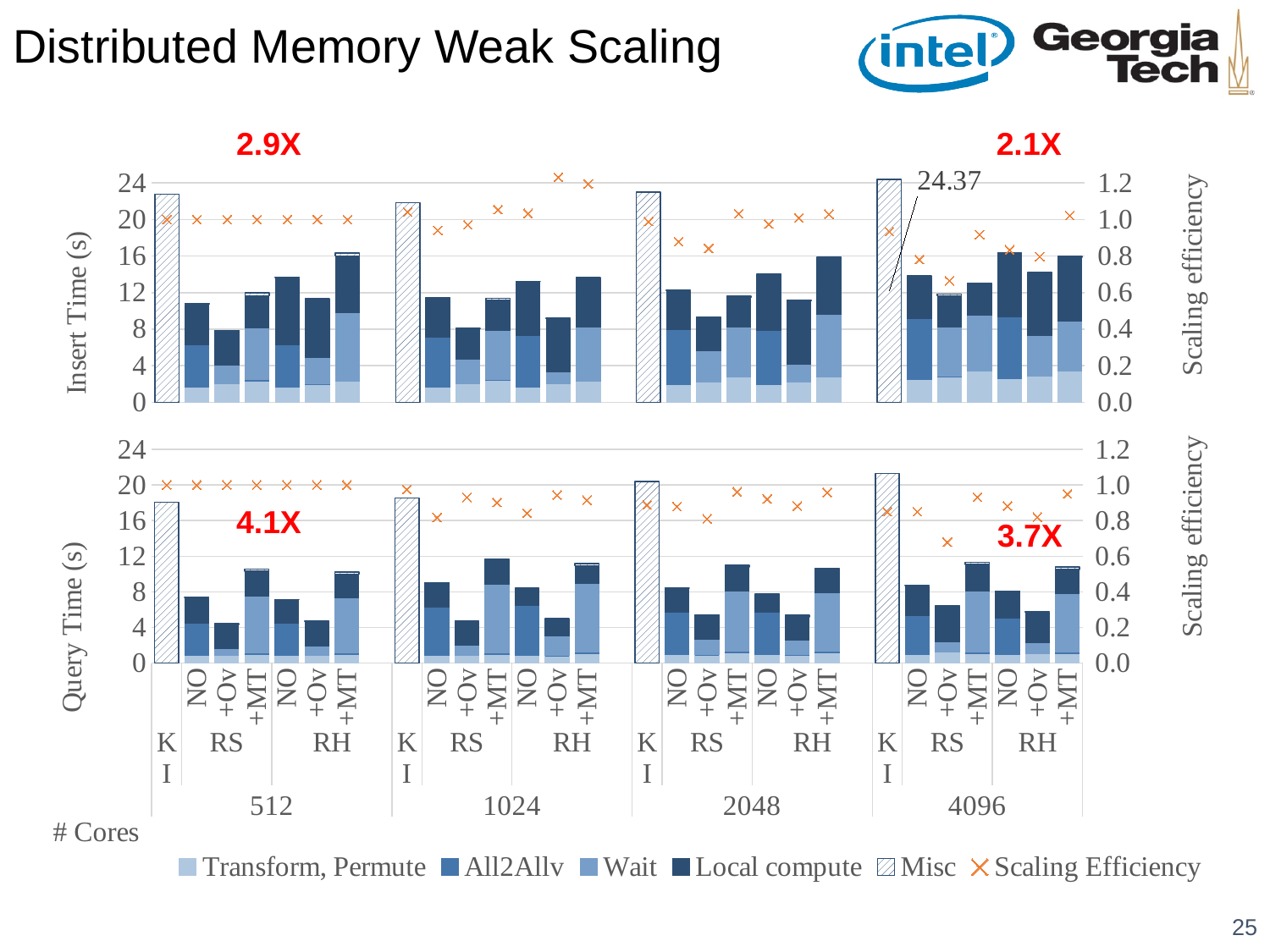
What speedup annotation is printed in red above the 512-core group in the Insert Time chart? 2.9X How many core counts are shown along the x axis of the charts? 4 In the Query Time chart, is the RS +Ov bar at 512 cores greater or less than 8? less What kind of chart is used for the Insert Time and Query Time panels on this slide? bar chart In the Insert Time chart, is the KI bar at 512 cores greater or less than 20? greater In the Insert Time chart, what value is labelled on the KI bar at 4096 cores? 24.37 In the Insert Time chart, at which core count is the KI bar tallest? 4096 In the Insert Time chart at 2048 cores, which bar is taller: RS +MT or RH +MT? RH +MT In the Query Time chart at 512 cores, which bar is taller: RS NO or RS +MT? RS +MT In the Insert Time chart, is the RH +MT bar at 512 cores greater or less than 12? greater How many entries does the legend at the bottom of the slide list? 6